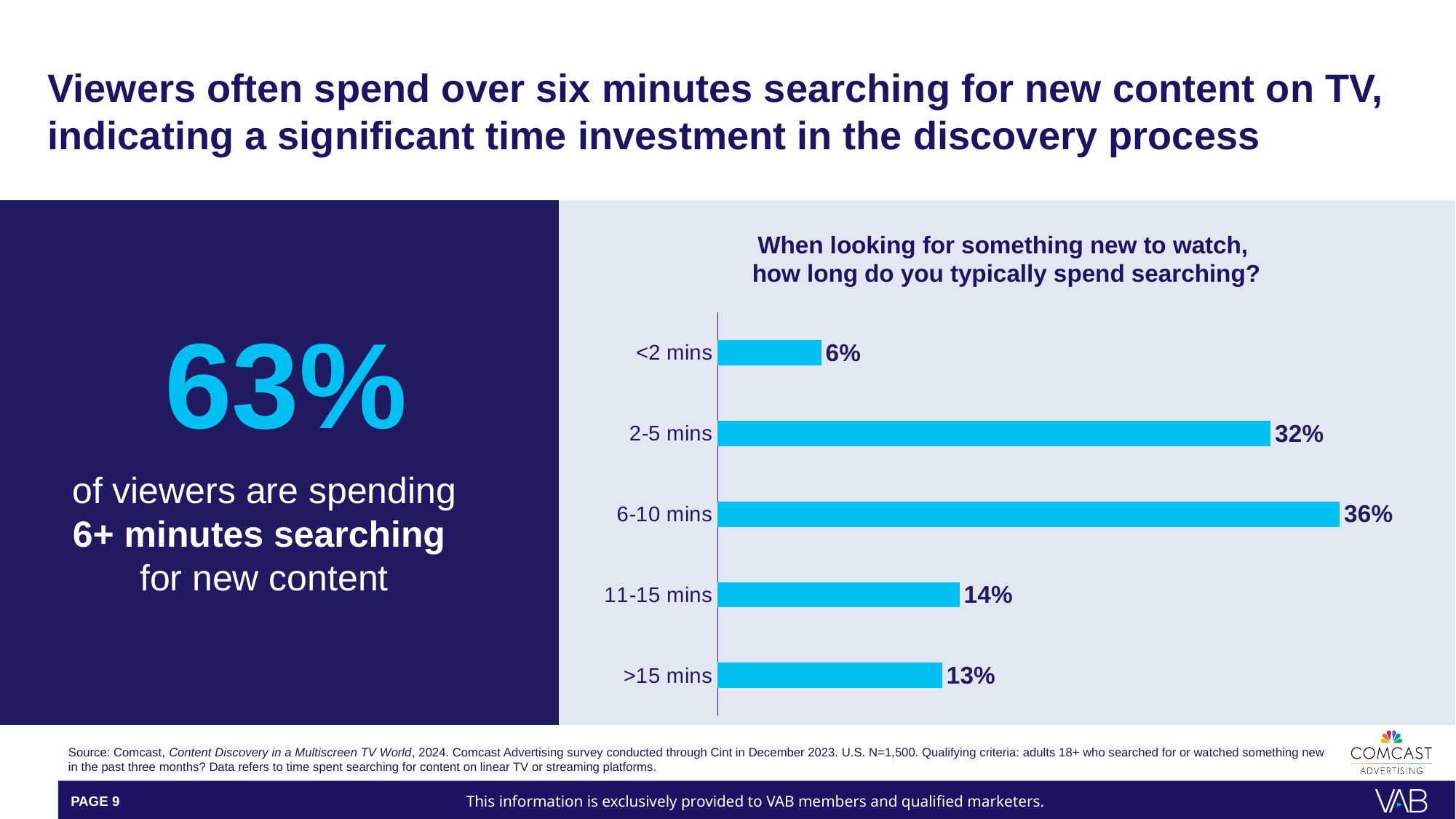
Which category has a larger share of respondents, 11-15 mins or >15 mins? 11-15 mins Which time range has the highest percentage of respondents? 6-10 mins How many time-range categories are shown in the chart? 5 What is the difference in percentage points between the 2-5 mins and 11-15 mins categories? 18 What large percentage is highlighted in the left panel of the slide? 63% Which time range has the lowest percentage of respondents? <2 mins What percentage of respondents typically spend >15 mins searching? 13% What percentage of respondents typically spend 6-10 mins searching for something new to watch? 36% What type of chart is used to show how long viewers spend searching? Bar chart What is the title of the chart? When looking for something new to watch, how long do you typically spend searching? What is the combined percentage of respondents who spend 2-5 mins or 6-10 mins searching? 68% What percentage of respondents typically spend <2 mins searching? 6%